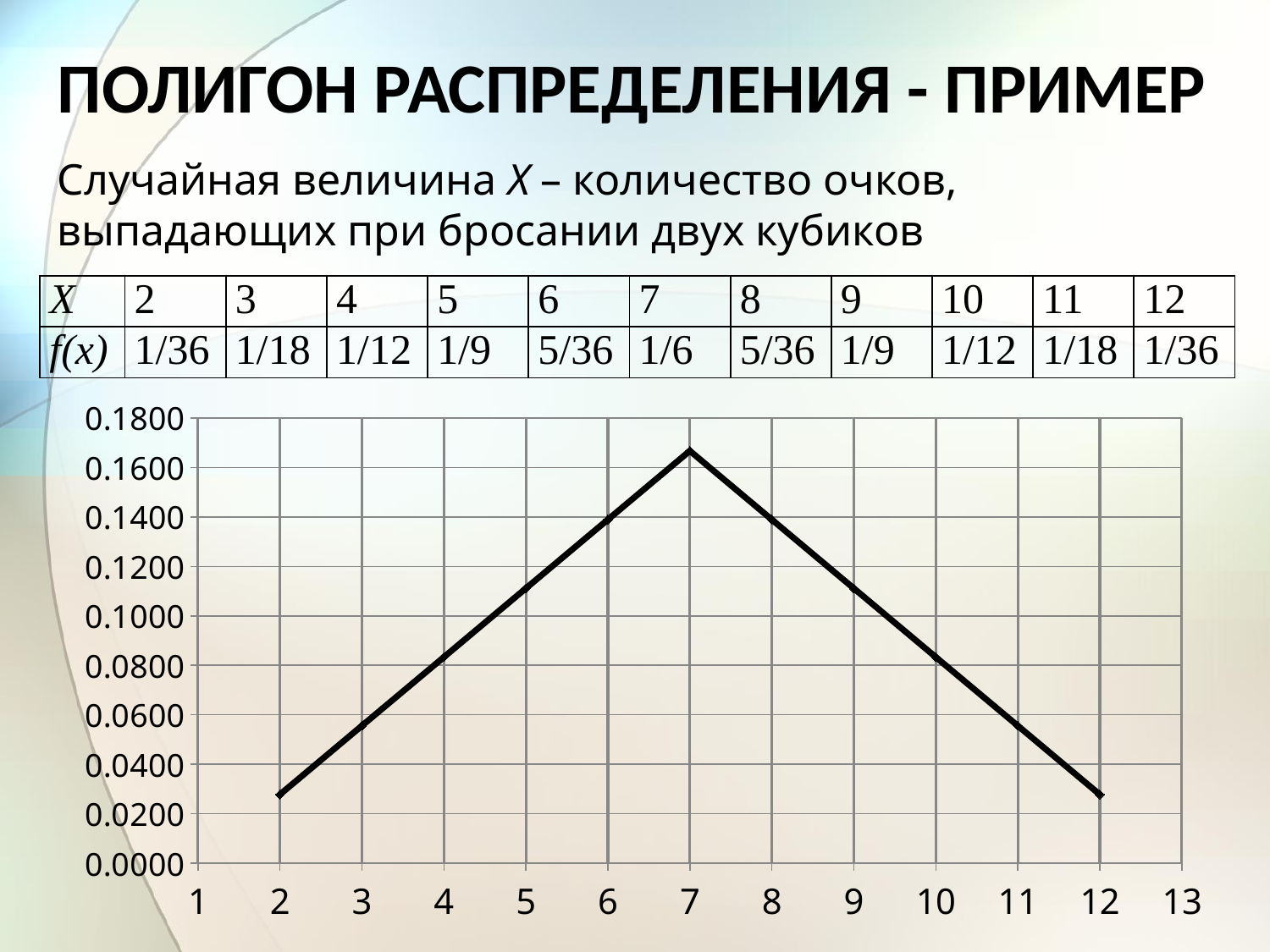
Which has the larger plotted value, X = 5 or X = 3? X = 5 Which has the larger plotted value, X = 7 or X = 12? X = 7 Is the plotted value at X = 9 greater or less than 0.1000? greater Do the plotted values rise or fall as X goes from 2 to 7? rise How many data points are plotted on the line chart? 11 At which value of X does the line chart reach its highest point? 7 Is the plotted value at X = 2 greater or less than 0.0400? less What kind of chart is shown on the slide? line chart Is the plotted value at X = 4 greater or less than 0.1000? less What is the highest tick value shown on the vertical axis of the chart? 0.1800 Do the plotted values rise or fall as X goes from 7 to 12? fall